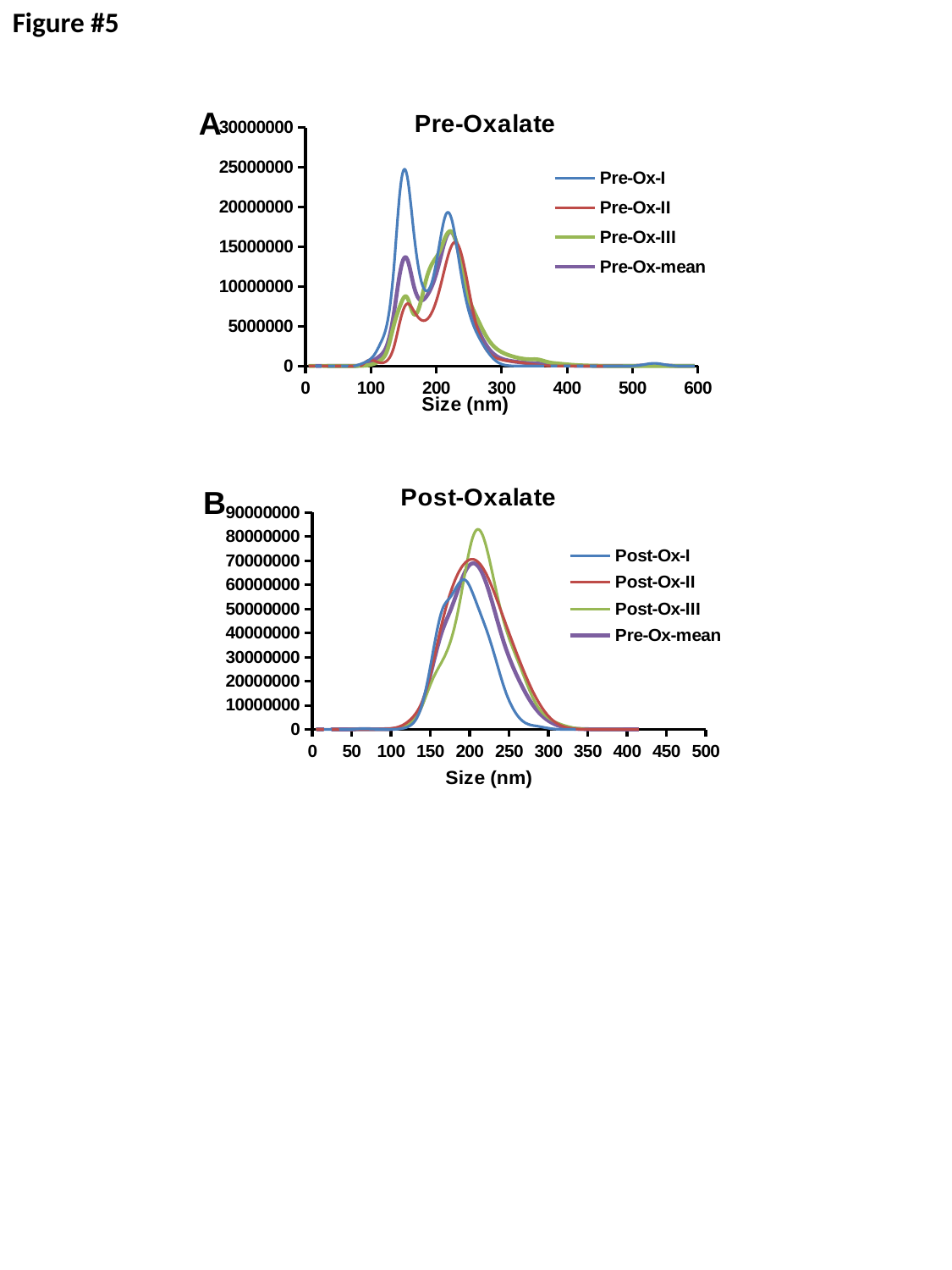
What is the x-axis label of the Post-Oxalate chart (panel B)? Size (nm) In the Post-Oxalate chart (panel B), is the peak value of Post-Ox-I greater or less than 70000000? less In the Pre-Oxalate chart (panel A), is the peak value of Pre-Ox-III greater or less than 20000000? less What is the highest value shown on the y-axis of the Post-Oxalate chart (panel B)? 90000000 How many series does the legend of the Post-Oxalate chart (panel B) list? 4 In the Post-Oxalate chart (panel B), is the peak value of Post-Ox-III greater or less than 70000000? greater What kind of chart is the Pre-Oxalate chart (panel A)? line chart In the Pre-Oxalate chart (panel A), which series reaches the highest peak value? Pre-Ox-I How many series does the legend of the Pre-Oxalate chart (panel A) list? 4 In the Post-Oxalate chart (panel B), which series reaches the highest peak value? Post-Ox-III In the Pre-Oxalate chart (panel A), which series has the higher peak, Pre-Ox-I or Pre-Ox-II? Pre-Ox-I